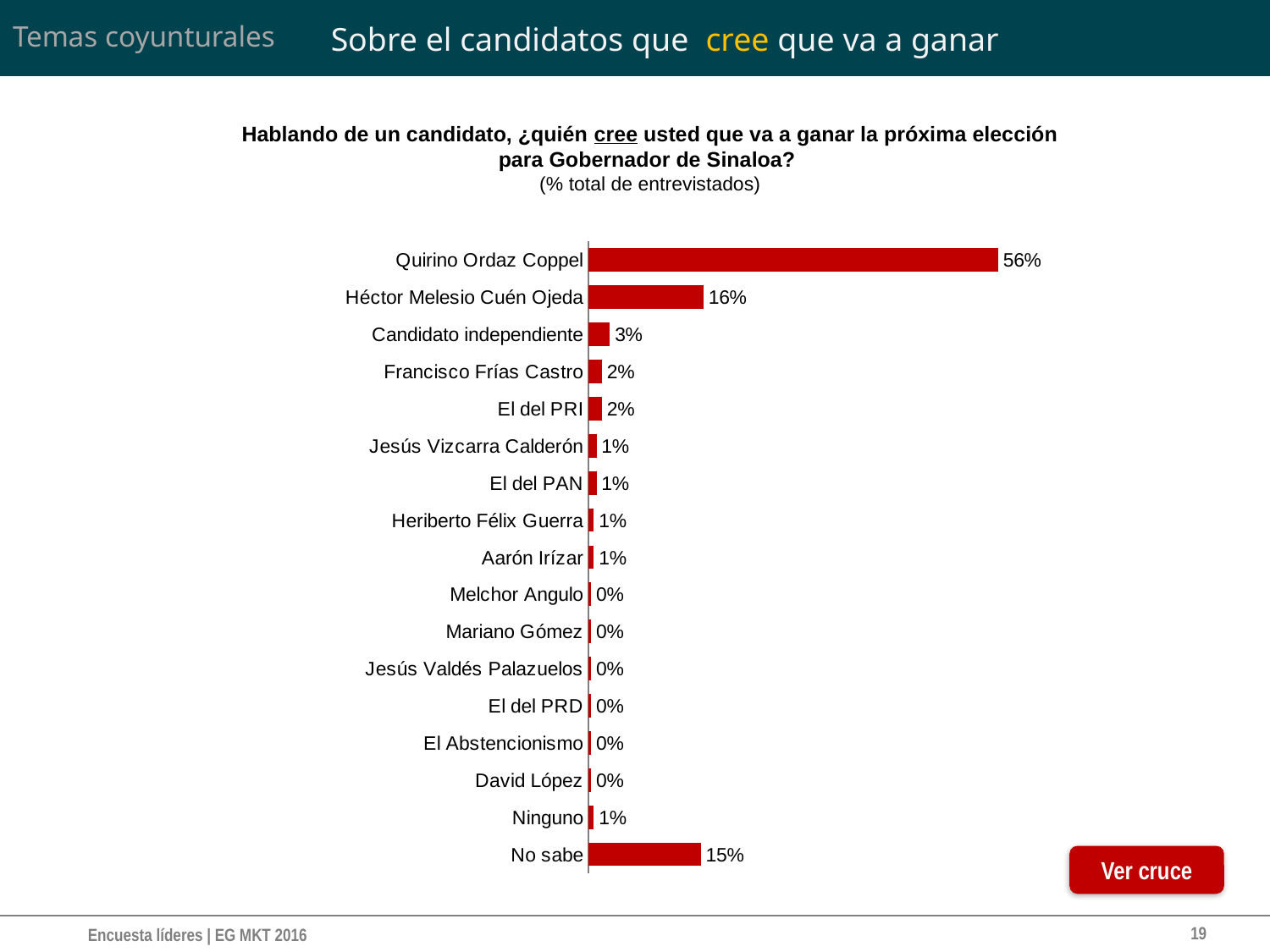
How many categories are shown in the chart? 17 What value is shown for Melchor Angulo? 0% What is the value shown for Héctor Melesio Cuén Ojeda? 16% What percentage of respondents believe Quirino Ordaz Coppel will win? 56% What type of chart is shown on the slide? Bar chart What percentage is shown for 'No sabe'? 15% What is the value shown for 'Ninguno'? 1% What is the difference between the percentages for Quirino Ordaz Coppel and Héctor Melesio Cuén Ojeda? 40 percentage points What is the difference between the values for Francisco Frías Castro and Jesús Vizcarra Calderón? 1 percentage point Which is larger, the value for Héctor Melesio Cuén Ojeda or the value for 'No sabe'? Héctor Melesio Cuén Ojeda What is the value for 'Candidato independiente'? 3% Which candidate has the highest percentage in the chart? Quirino Ordaz Coppel